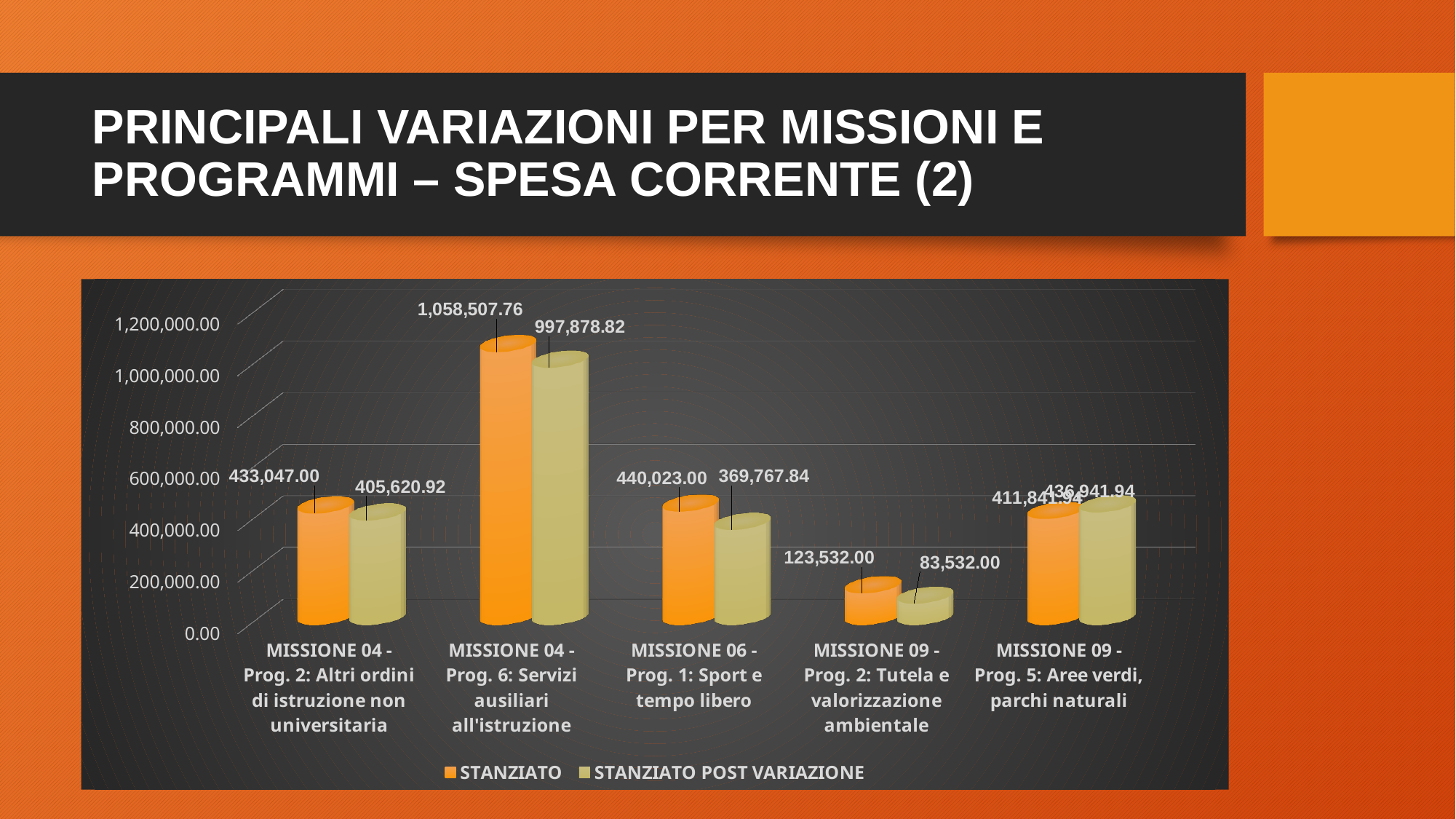
How many series does the legend list? 2 What is the STANZIATO value for MISSIONE 04 - Prog. 6: Servizi ausiliari all'istruzione? 1,058,507.76 How many categories (missions/programmes) are shown on the x axis? 5 What type of chart is shown on the slide? bar chart What is the STANZIATO POST VARIAZIONE value for MISSIONE 06 - Prog. 1: Sport e tempo libero? 369,767.84 Which category has the highest STANZIATO value? MISSIONE 04 - Prog. 6: Servizi ausiliari all'istruzione What is the difference between the STANZIATO and STANZIATO POST VARIAZIONE values for MISSIONE 04 - Prog. 2: Altri ordini di istruzione non universitaria? 27,426.08 Which series is shown in orange in the legend? STANZIATO For MISSIONE 06 - Prog. 1: Sport e tempo libero, which is larger: STANZIATO or STANZIATO POST VARIAZIONE? STANZIATO Which category has the lowest STANZIATO POST VARIAZIONE value? MISSIONE 09 - Prog. 2: Tutela e valorizzazione ambientale What is the difference between the STANZIATO and STANZIATO POST VARIAZIONE values for MISSIONE 09 - Prog. 2: Tutela e valorizzazione ambientale? 40,000.00 What is the STANZIATO POST VARIAZIONE value for MISSIONE 09 - Prog. 2: Tutela e valorizzazione ambientale? 83,532.00